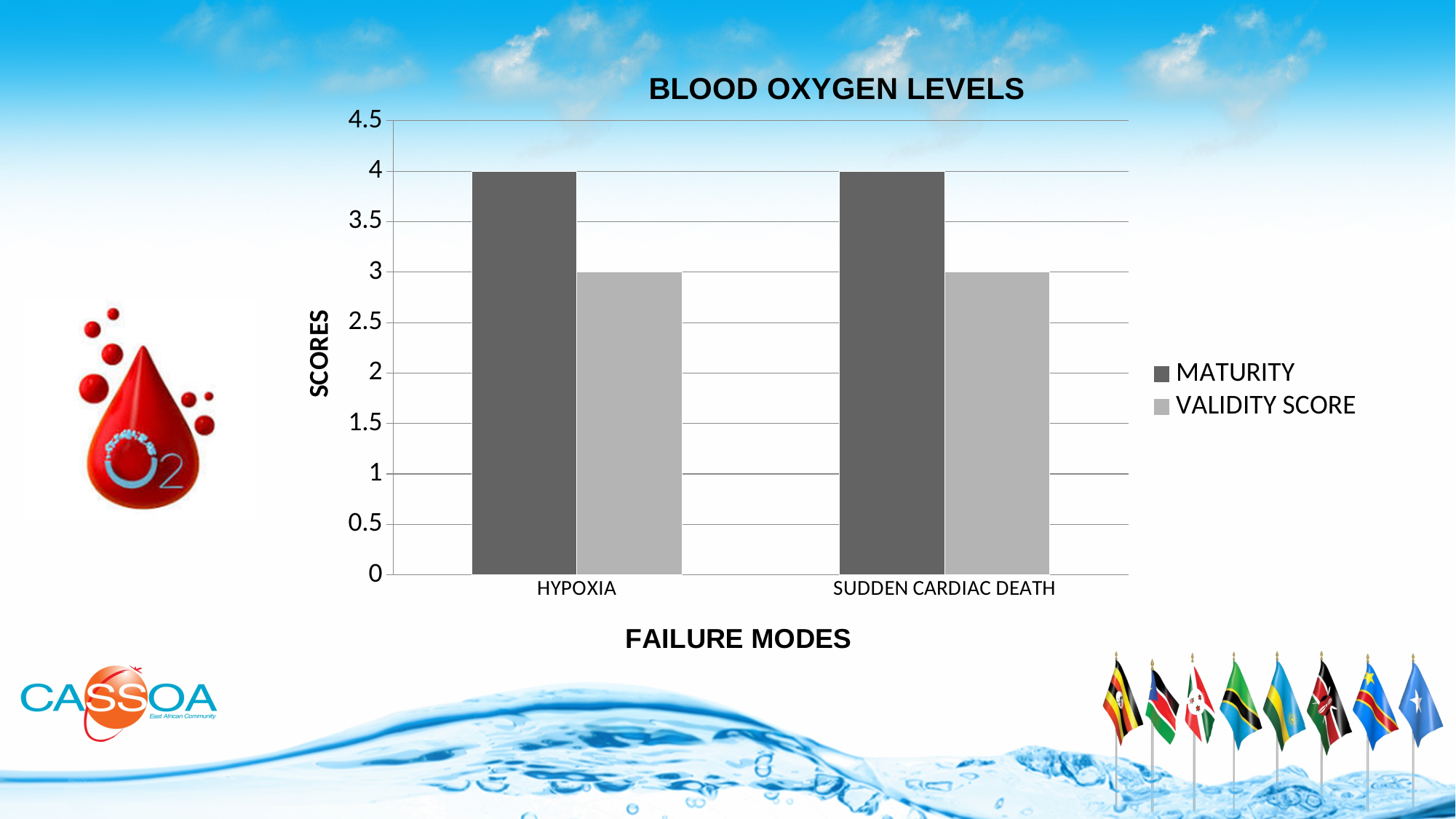
What is the VALIDITY SCORE for HYPOXIA? 3 Is the VALIDITY SCORE for HYPOXIA greater or less than 3.5? less What is the title of the chart? BLOOD OXYGEN LEVELS What is the VALIDITY SCORE for SUDDEN CARDIAC DEATH? 3 How many series does the legend list? 2 For HYPOXIA, which is larger, the MATURITY score or the VALIDITY SCORE? MATURITY What is the MATURITY score for HYPOXIA? 4 What type of chart is shown on the slide? bar chart What is the MATURITY score for SUDDEN CARDIAC DEATH? 4 What is the difference between the MATURITY score and the VALIDITY SCORE for SUDDEN CARDIAC DEATH? 1 What is the label of the y axis? SCORES How many failure modes are shown on the x axis? 2